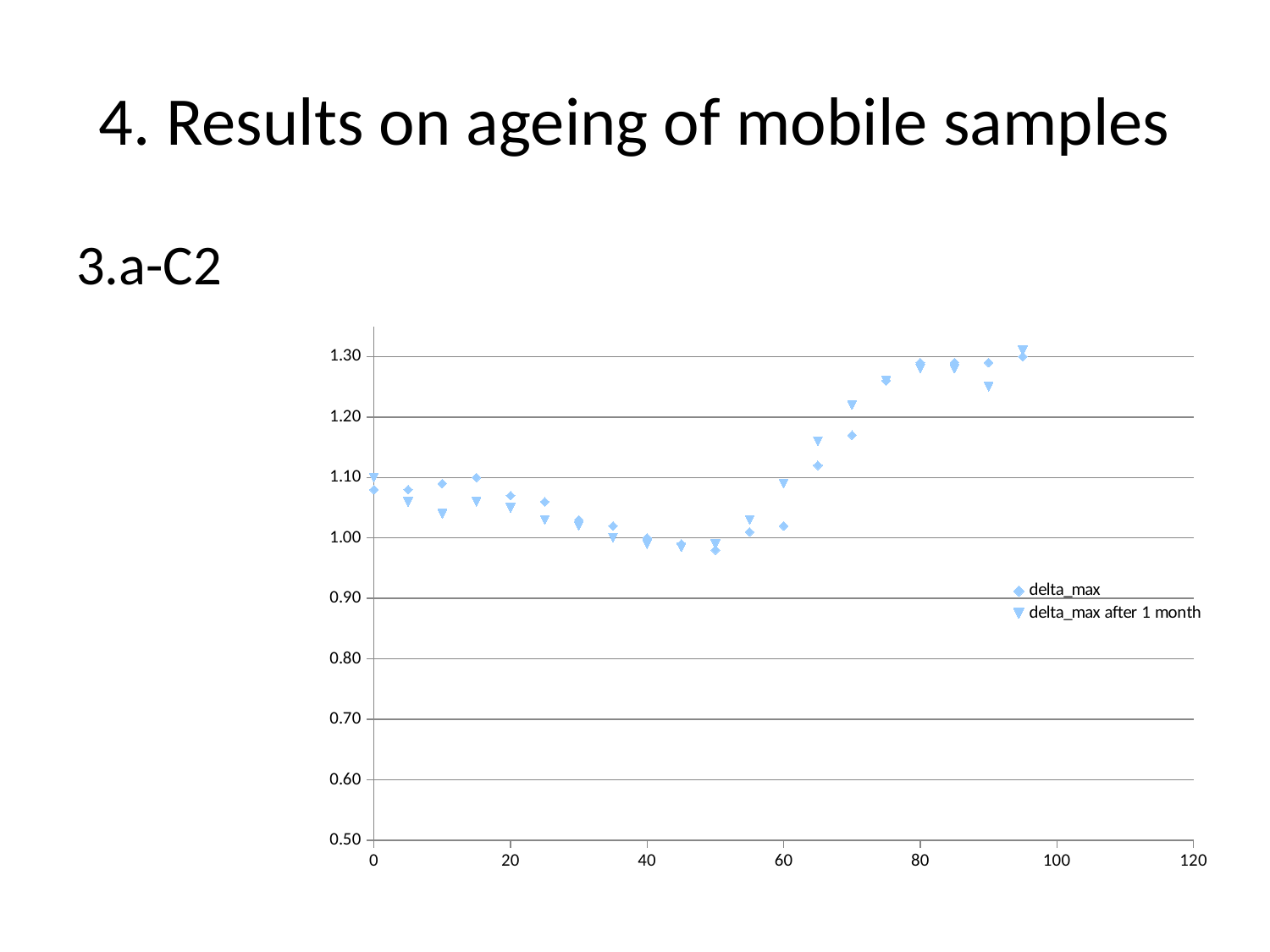
How many data points are plotted for the delta_max series? 20 What are the two series named in the legend? delta_max and delta_max after 1 month How many series does the legend list? 2 Is the delta_max value at x = 0 greater or less than 1.00? greater Do the delta_max values rise or fall between x = 50 and x = 95? rise At x = 90, which series has the larger value, delta_max or delta_max after 1 month? delta_max Is the delta_max after 1 month value at x = 60 greater or less than 1.00? greater Is the delta_max value at x = 50 greater or less than 1.00? less At which x value does the delta_max after 1 month series reach its highest point? 95 At x = 65, which series has the larger value, delta_max or delta_max after 1 month? delta_max after 1 month What kind of chart is shown on the slide? scatter chart